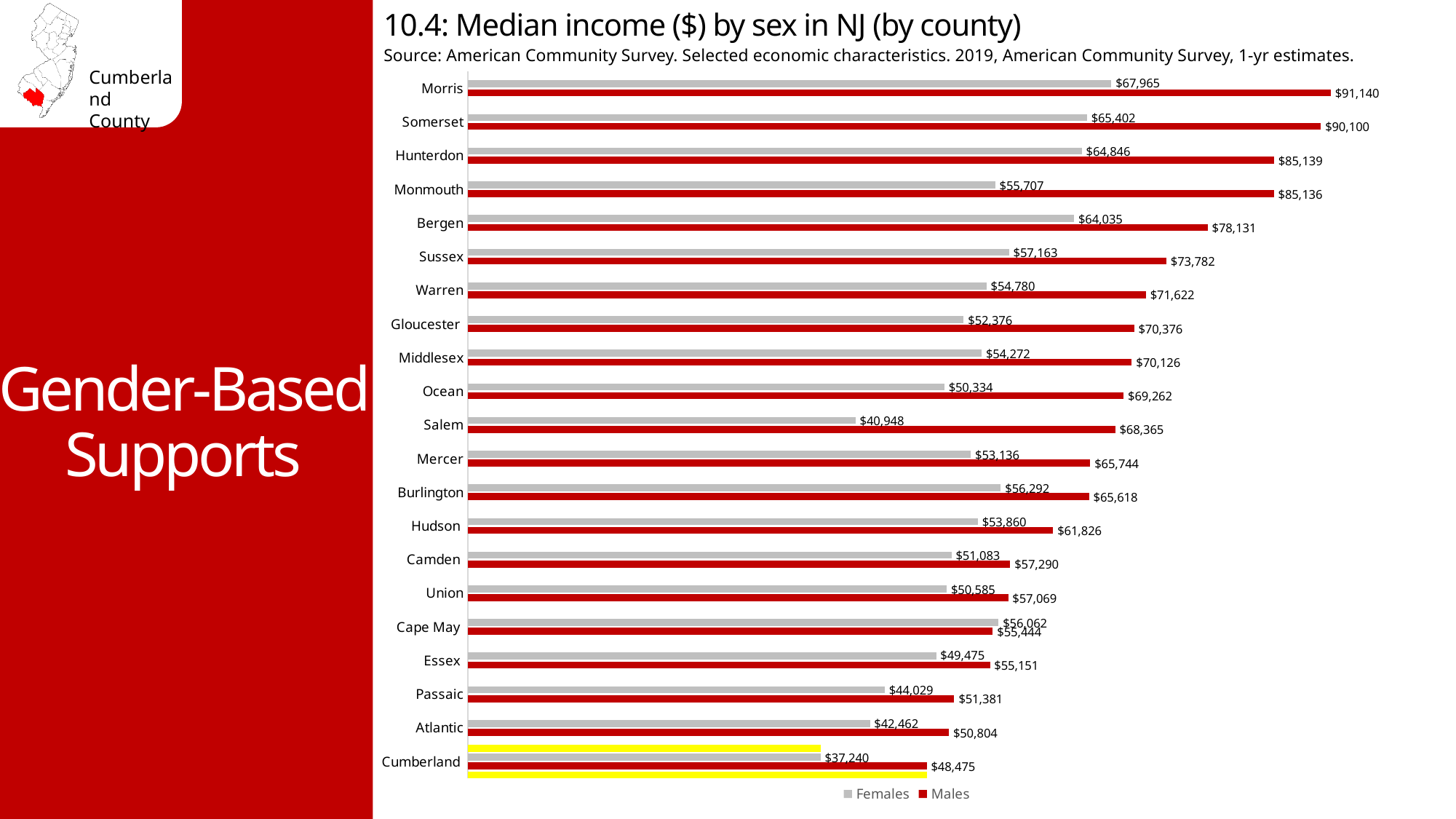
What is the median income for Females in Cumberland County? $37,240 In Cape May County, which is larger: the Females or the Males median income? Females How many counties are shown in the chart? 21 What colour represents the Males series in the chart? Red What is the difference between the Males and Females median income in Cumberland County? $11,235 What is the difference between the Males and Females median income in Morris County? $23,175 What is the median income for Females in Salem County? $40,948 Which county has the highest median income for Males? Morris How many series does the legend list? 2 Which county has the lowest median income for Females? Cumberland What is the median income for Males in Morris County? $91,140 What kind of chart is shown on the slide? Bar chart